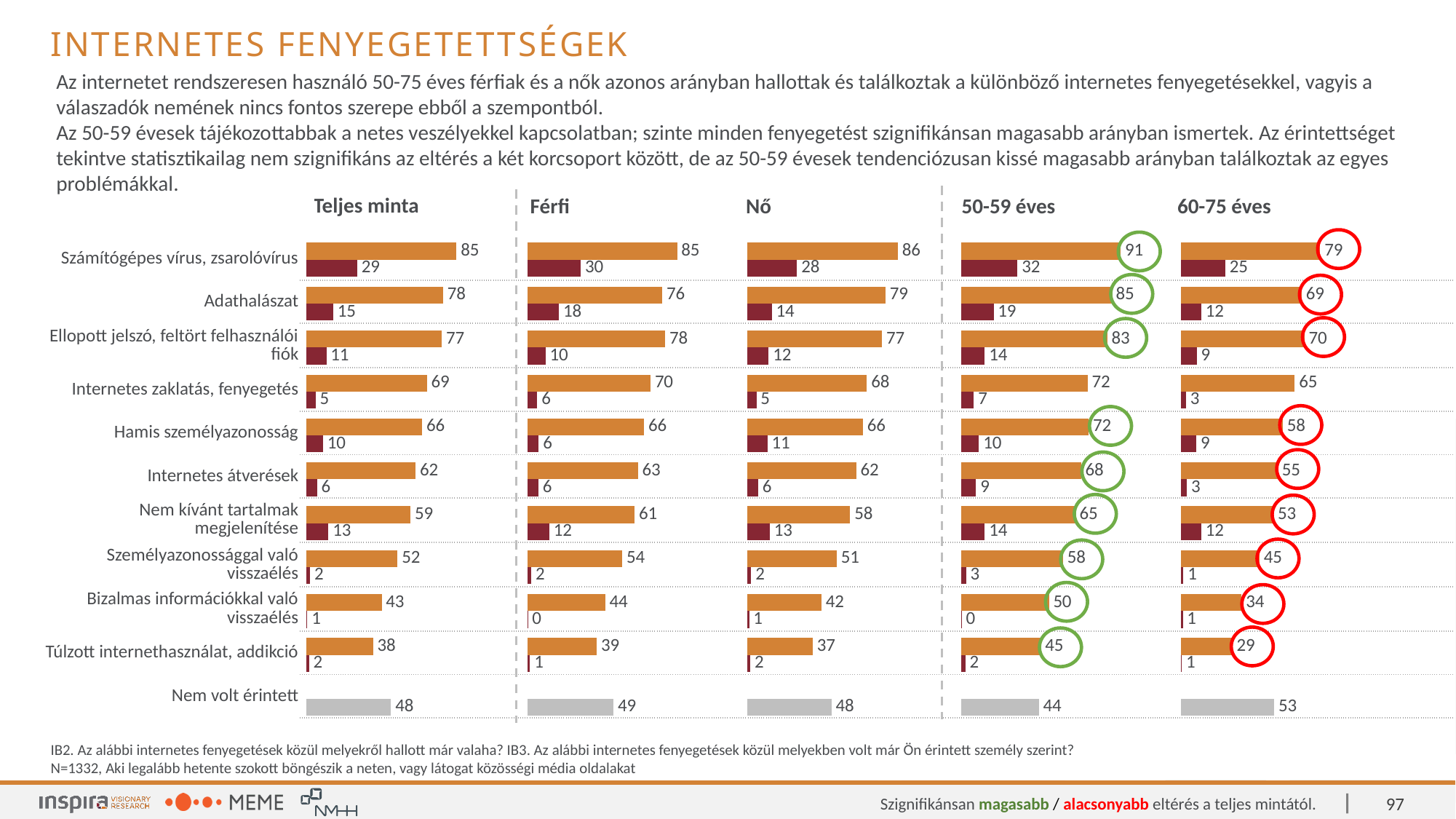
In the 'Férfi' chart, what is the value of the dark red bar for 'Adathalászat'? 18 What is the difference between the orange bar values for 'Adathalászat' in the '50-59 éves' chart and the '60-75 éves' chart? 16 Which is larger: the orange bar value for 'Internetes zaklatás, fenyegetés' in the 'Férfi' chart or in the 'Nő' chart? Férfi In the 'Teljes minta' chart, what is the value of the orange bar for 'Számítógépes vírus, zsarolóvírus'? 85 How many group charts (column panels) are shown on the slide? 5 In the 'Teljes minta' chart, do the orange bar values rise or fall going down the list from 'Számítógépes vírus, zsarolóvírus' to 'Túlzott internethasználat, addikció'? Fall How many threat categories (excluding 'Nem volt érintett') are listed in the 'Teljes minta' chart? 10 What type of chart is used on this slide? Bar chart In the '50-59 éves' chart, which category has the highest orange bar value? Számítógépes vírus, zsarolóvírus In the '60-75 éves' chart, what is the value of the dark red bar for 'Bizalmas információkkal való visszaélés'? 1 In the '60-75 éves' chart, which category has the lowest orange bar value? Túlzott internethasználat, addikció In the 'Nő' chart, what is the value of the grey 'Nem volt érintett' bar? 48